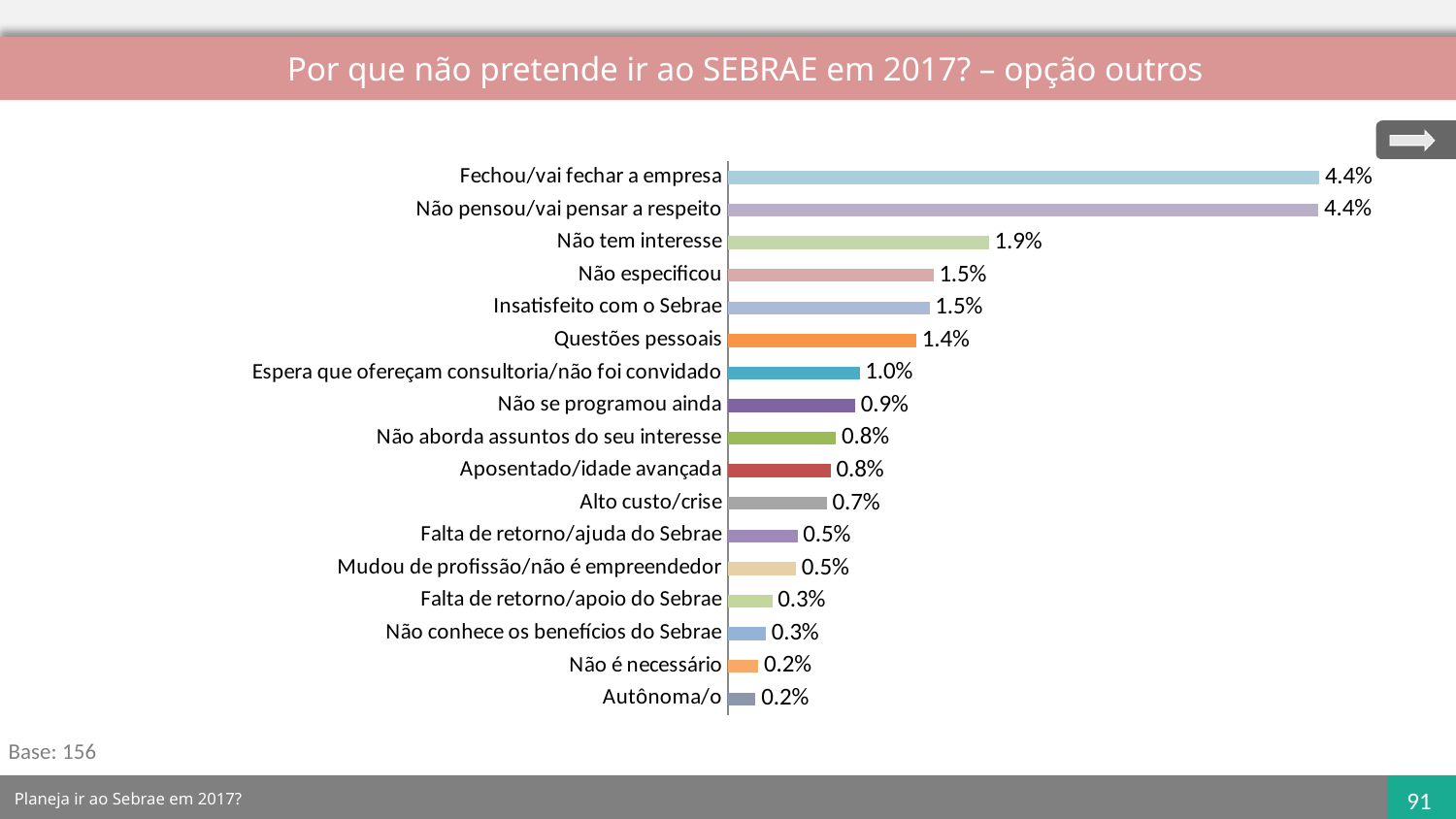
What is the value for "Não tem interesse"? 1.9% What is the value for "Questões pessoais"? 1.4% Which two categories share the highest value in the chart? Fechou/vai fechar a empresa and Não pensou/vai pensar a respeito What is the difference between the values for "Fechou/vai fechar a empresa" and "Não tem interesse"? 2.5% What is the highest value shown in the chart? 4.4% What is the difference between the values for "Não especificou" and "Alto custo/crise"? 0.8% What is the value for "Autônoma/o"? 0.2% How many categories are shown in the chart? 17 Which is larger, the value for "Questões pessoais" or the value for "Não se programou ainda"? Questões pessoais What kind of chart is shown on the slide? Bar chart What is the value for "Não se programou ainda"? 0.9% What is the value for "Alto custo/crise"? 0.7%